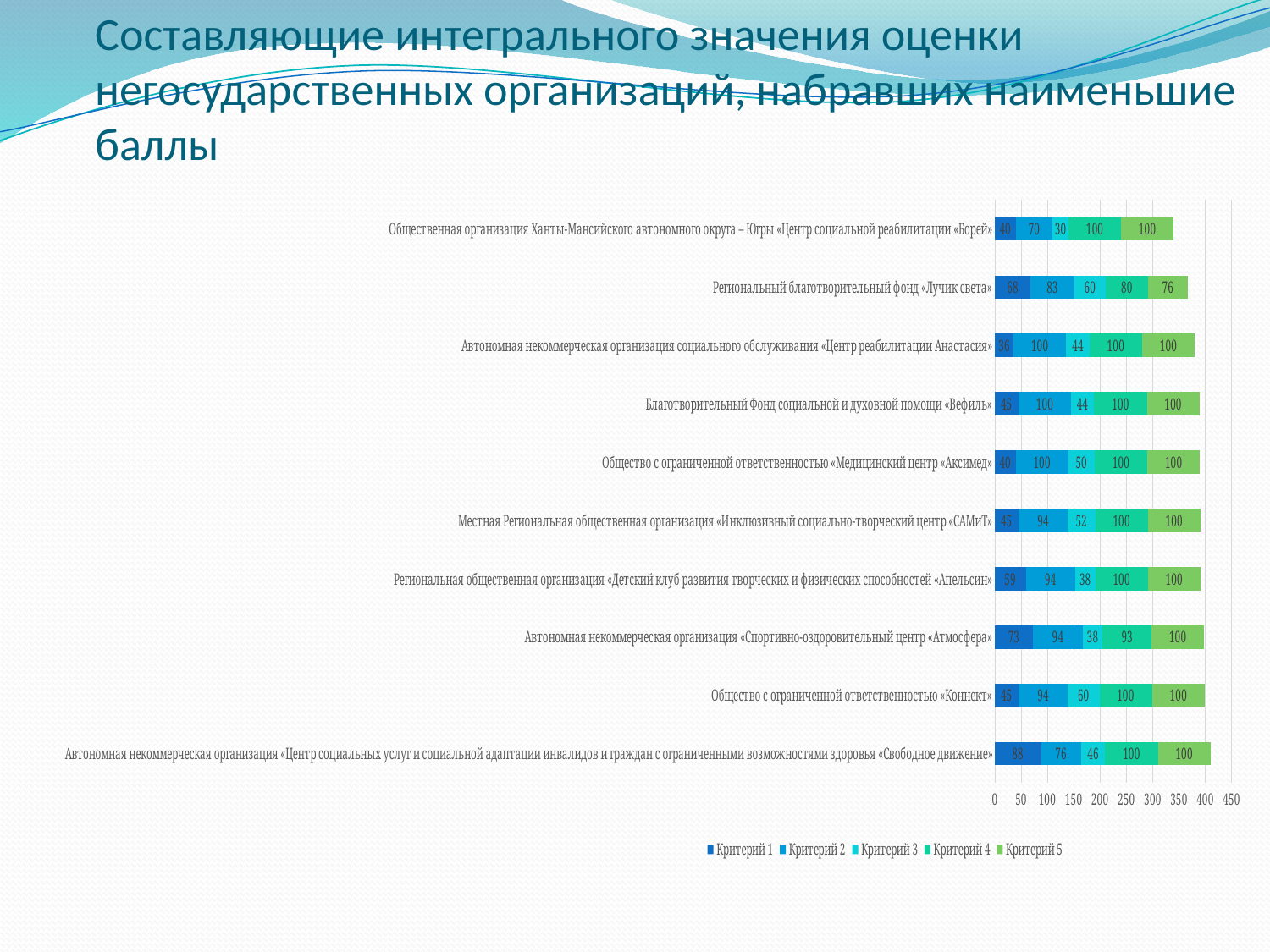
Which organization has the highest value for Критерий 1? Автономная некоммерческая организация «Центр социальных услуг и социальной адаптации инвалидов и граждан с ограниченными возможностями здоровья «Свободное движение» What is the value of Критерий 1 for Региональный благотворительный фонд «Лучик света»? 68 How many series does the legend list? 5 How many organizations (categories) are plotted in the chart? 10 What is the total of the stacked bar for Общественная организация Ханты-Мансийского автономного округа – Югры «Центр социальной реабилитации «Борей»? 340 What is the last entry listed in the legend? Критерий 5 What is the value of Критерий 4 for Автономная некоммерческая организация «Спортивно-оздоровительный центр «Атмосфера»? 93 What kind of chart is shown on the slide? Stacked bar chart Which organization has the lowest value for Критерий 1? Автономная некоммерческая организация социального обслуживания «Центр реабилитации Анастасия» Which is larger: the Критерий 3 value for Общество с ограниченной ответственностью «Коннект» or for Региональная общественная организация «Детский клуб развития творческих и физических способностей «Апельсин»? Общество с ограниченной ответственностью «Коннект» What is the value of Критерий 3 for Общественная организация Ханты-Мансийского автономного округа – Югры «Центр социальной реабилитации «Борей»? 30 What is the difference between the Критерий 2 values for «Центр реабилитации Анастасия» and «Лучик света»? 17